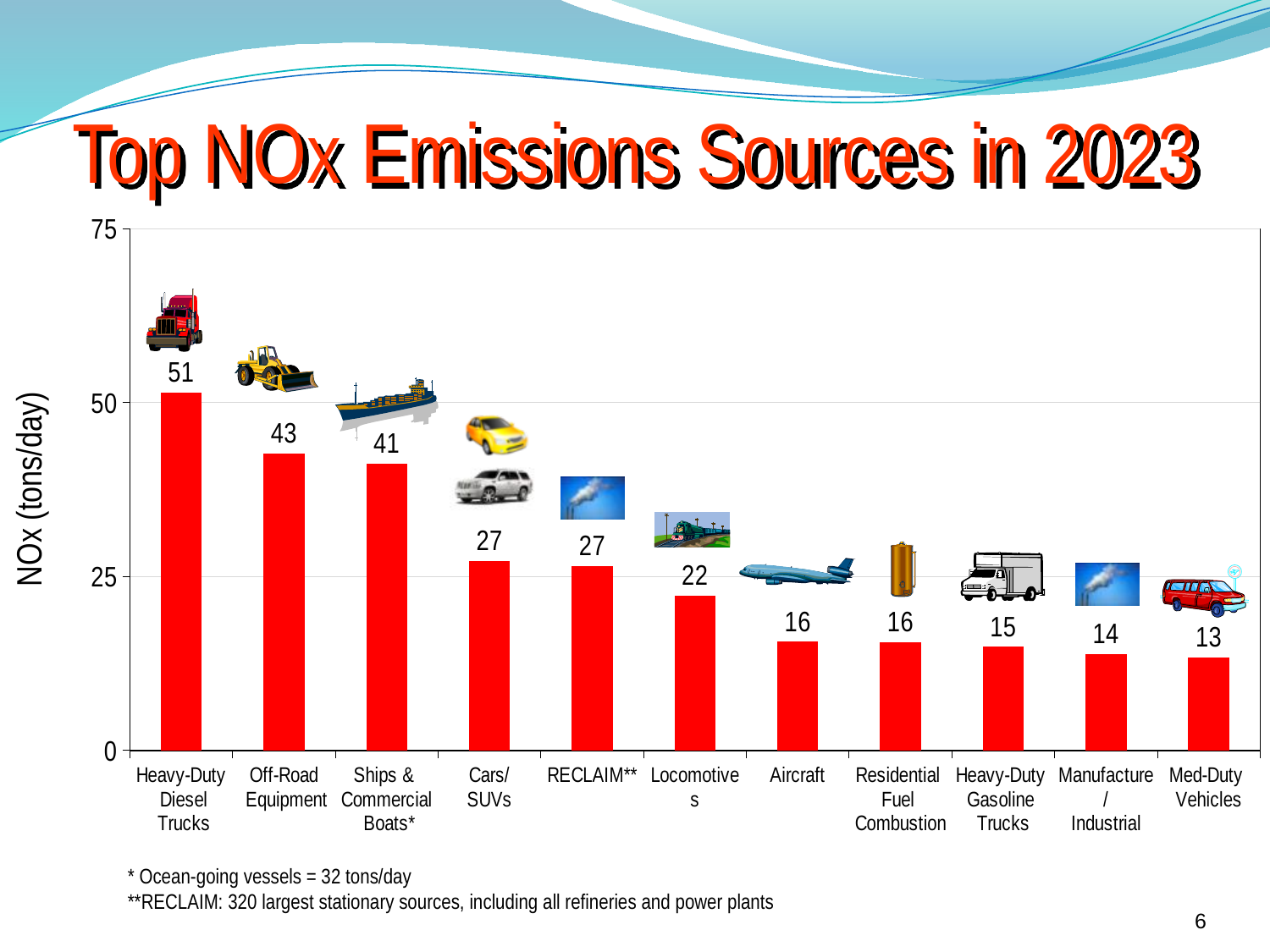
How many emission sources are shown in the chart? 11 What is the difference in NOx emissions between Heavy-Duty Diesel Trucks and Med-Duty Vehicles? 38 Which source has the highest NOx emissions? Heavy-Duty Diesel Trucks Do the values rise or fall from left to right across the chart? Fall Which has higher NOx emissions, Cars/SUVs or Locomotives? Cars/SUVs What is the NOx emissions value for Heavy-Duty Diesel Trucks? 51 What is the label of the y-axis? NOx (tons/day) What is the difference in NOx emissions between Off-Road Equipment and Ships & Commercial Boats? 2 What is the NOx emissions value for Aircraft? 16 Which source has the lowest NOx emissions? Med-Duty Vehicles What is the NOx emissions value for Locomotives? 22 What type of chart is shown on the slide? Bar chart